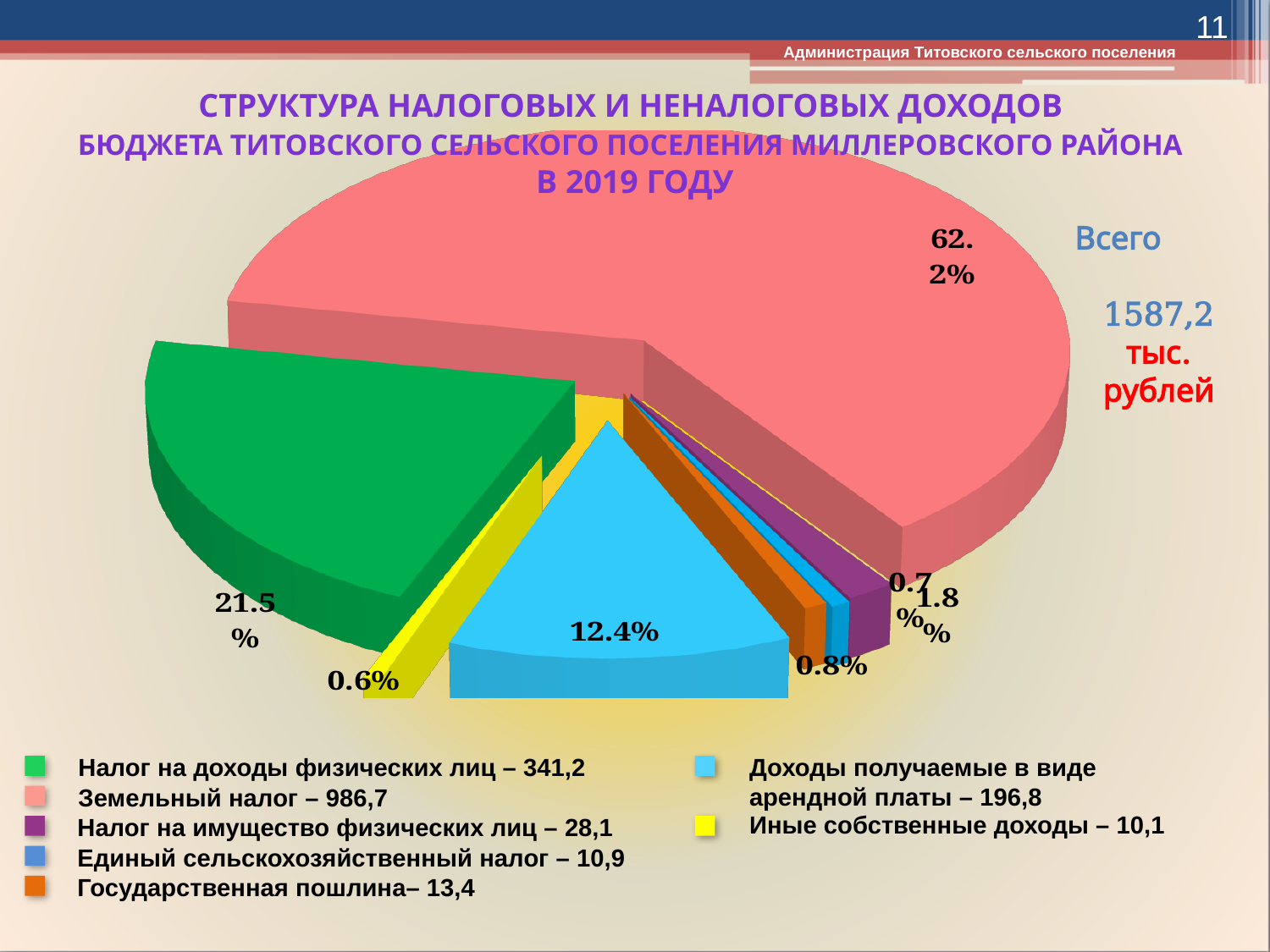
Which category has the smallest slice of the pie? Иные собственные доходы What kind of chart is shown on the slide? pie chart Which category has the largest slice of the pie? Земельный налог What share of the pie does Налог на доходы физических лиц account for? 21.5% What is the value shown in the legend for Налог на доходы физических лиц? 341,2 What total amount (Всего) is shown next to the pie chart? 1587,2 тыс. рублей What share of the pie does Доходы получаемые в виде арендной платы account for? 12.4% What is the value shown in the legend for Государственная пошлина? 13,4 Which is larger: Налог на доходы физических лиц or Доходы получаемые в виде арендной платы? Налог на доходы физических лиц What share of the pie does Земельный налог account for? 62.2% How many categories (slices) does the pie chart have? 7 What is the difference between the values for Земельный налог and Налог на доходы физических лиц? 645,5